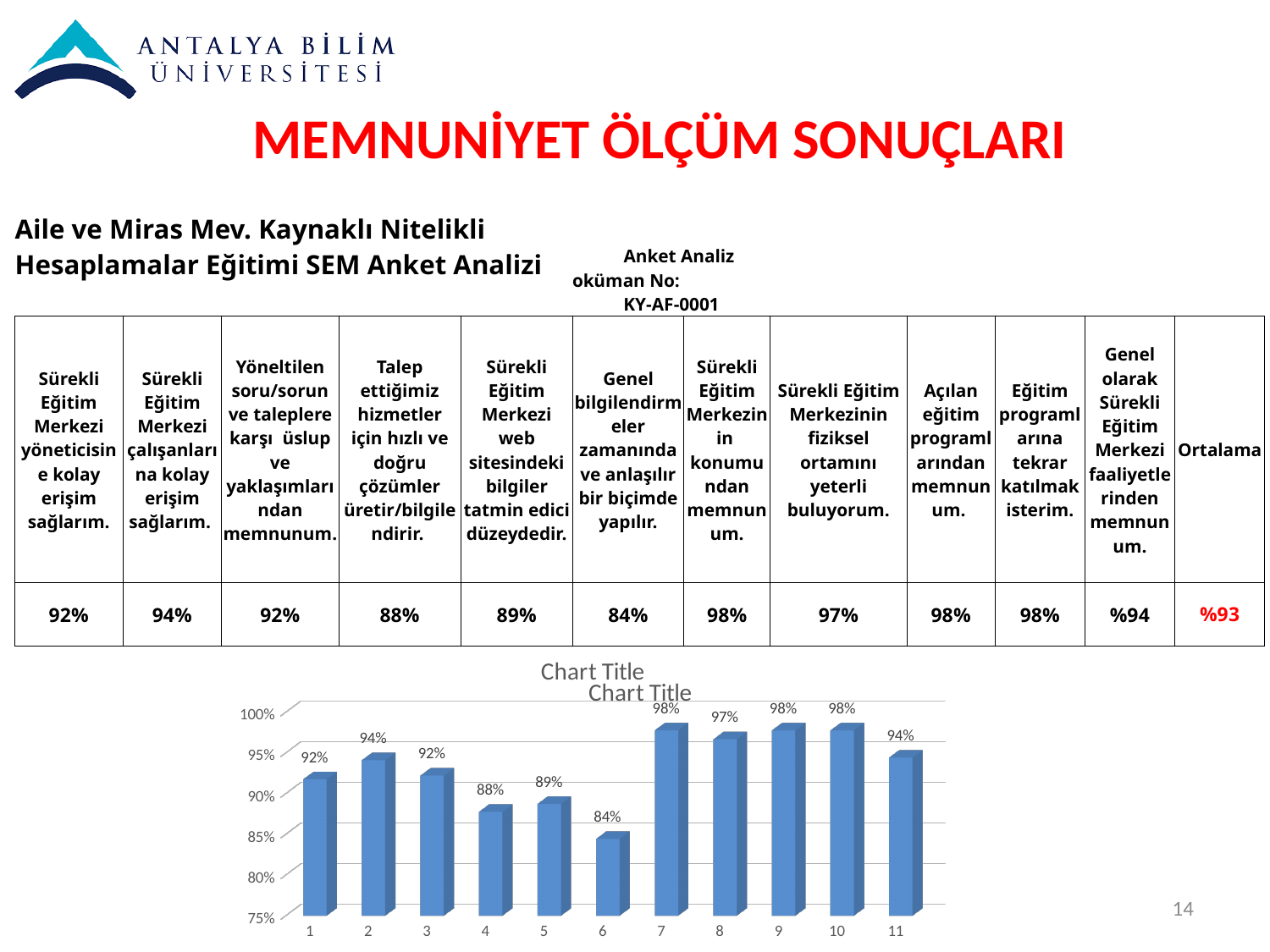
How many bars are plotted in the chart? 11 What is the lowest value shown on the vertical axis of the chart? 75% What is the title shown above the chart? Chart Title What is the value of bar 8 in the chart? 97% What is the difference between the values of bar 7 and bar 6? 14% What is the highest value shown in the chart? 98% Which category has the lowest value in the chart? 6 Which is larger, the value for bar 2 or the value for bar 5? bar 2 What type of chart is shown on the slide? bar chart What is the value of bar 6 in the chart? 84% Is the value for bar 6 greater or less than 85%? less What is the value of bar 4 in the chart? 88%